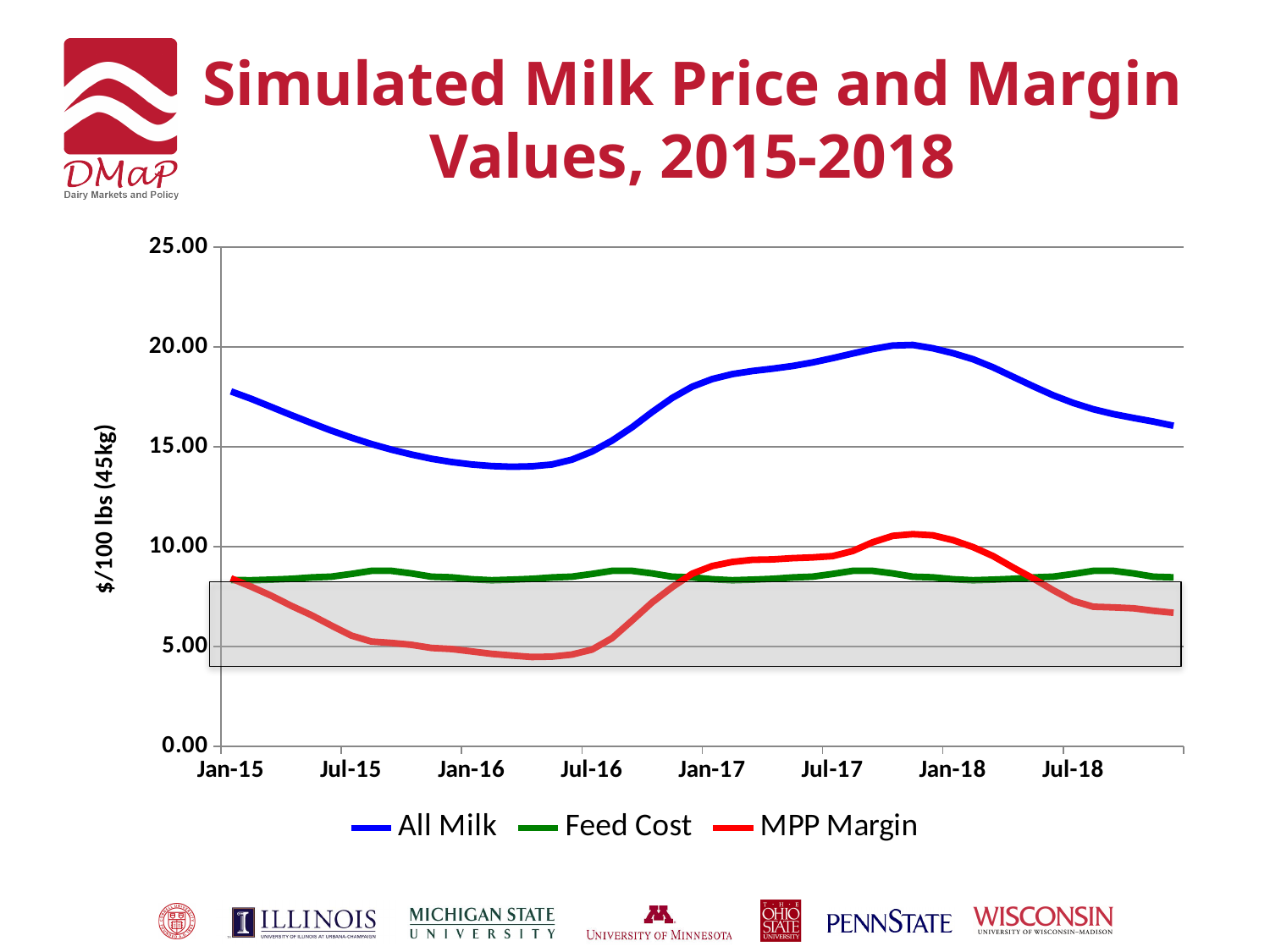
What kind of chart is shown on the slide? line chart What is the label on the y axis? $/100 lbs (45kg) Is the MPP Margin value at Jan-17 greater or less than 5.00? greater At Jan-18, which is larger: MPP Margin or Feed Cost? MPP Margin Is the All Milk value at Jan-16 greater or less than 15.00? less Is the Feed Cost value at Jan-17 greater or less than 10.00? less Which series has the lowest value at Jan-16? MPP Margin Which series has the highest values across the whole chart? All Milk What is the title of the chart? Simulated Milk Price and Margin Values, 2015-2018 Does the All Milk line rise or fall from Jan-15 to Jan-16? fall How many series does the legend list? 3